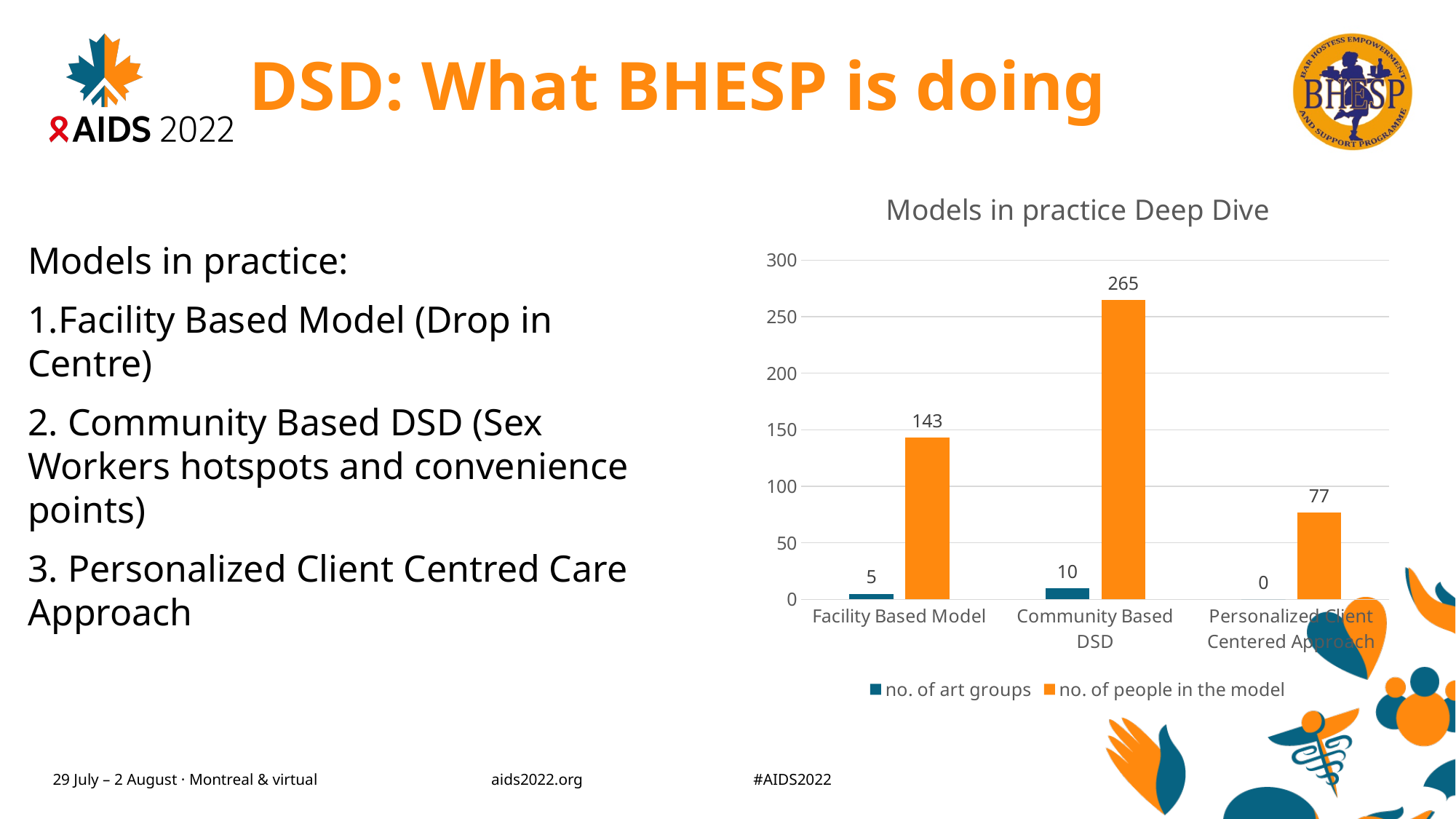
What is the number of people in the model for Community Based DSD? 265 Is the number of people in the model for Facility Based Model greater or less than 100? greater What is the number of art groups for Personalized Client Centered Approach? 0 What is the number of art groups for Facility Based Model? 5 Which category has the highest number of people in the model? Community Based DSD Which category has the lowest number of art groups? Personalized Client Centered Approach What is the difference in the number of people in the model between Community Based DSD and Facility Based Model? 122 What is the title of the chart? Models in practice Deep Dive How many series does the chart legend list? 2 Which has more art groups, Facility Based Model or Community Based DSD? Community Based DSD What is the number of people in the model for Personalized Client Centered Approach? 77 How many categories are shown on the x axis of the chart? 3